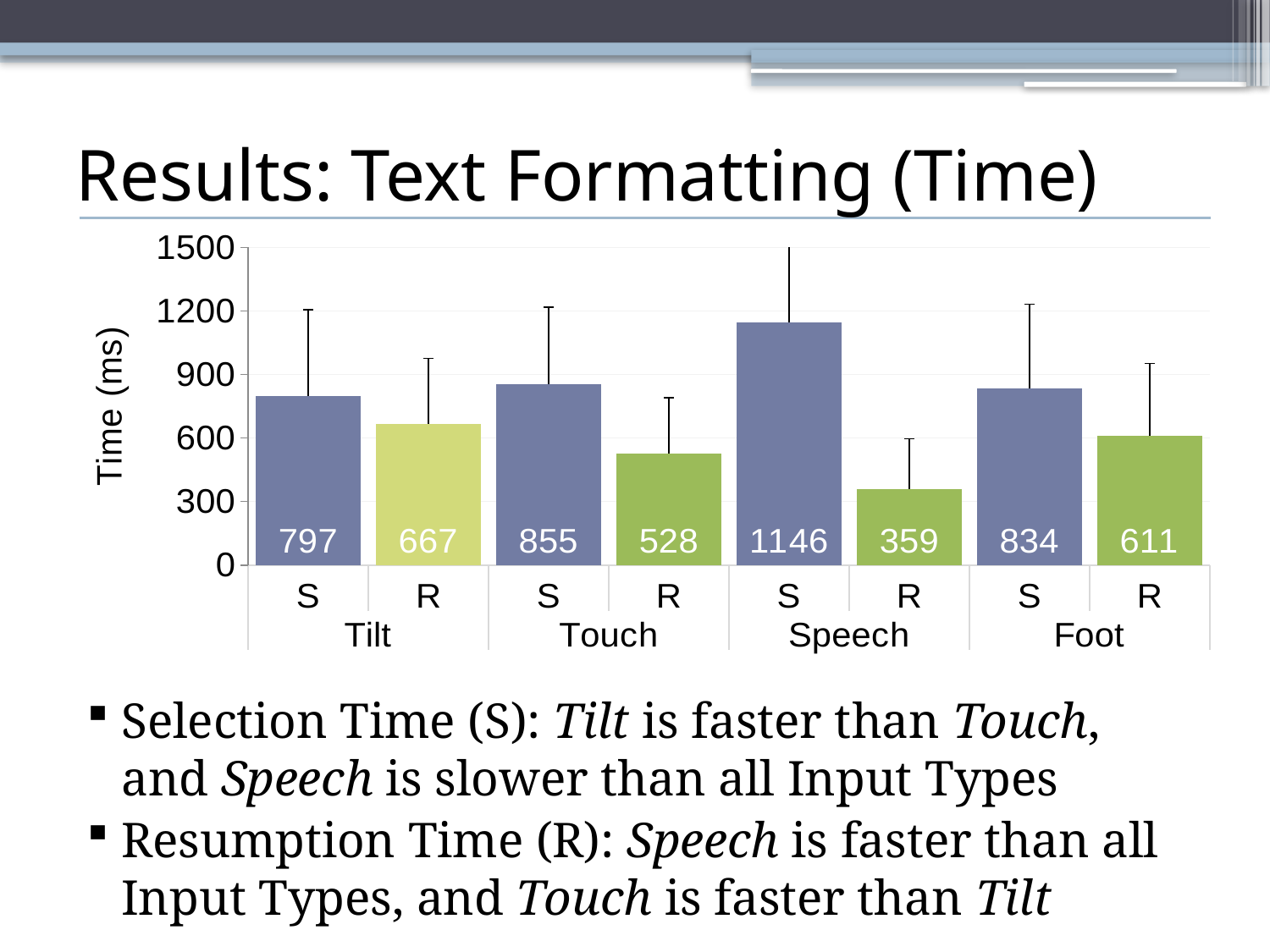
Which bar has the lowest value in the chart? Speech R What is the S value for Tilt? 797 What is the R value for Foot? 611 How many bars are plotted in the chart? 8 Which is larger, the R value for Tilt or the R value for Touch? Tilt Is the S value for Foot greater or less than 600? greater What is the Resumption Time (R) value for Touch? 528 What type of chart is shown on the slide? bar chart Which bar has the highest value in the chart? Speech S What is the difference between the S values for Touch and Tilt? 58 What is the difference between the S and R values for Speech? 787 What is the Selection Time (S) value for Speech? 1146